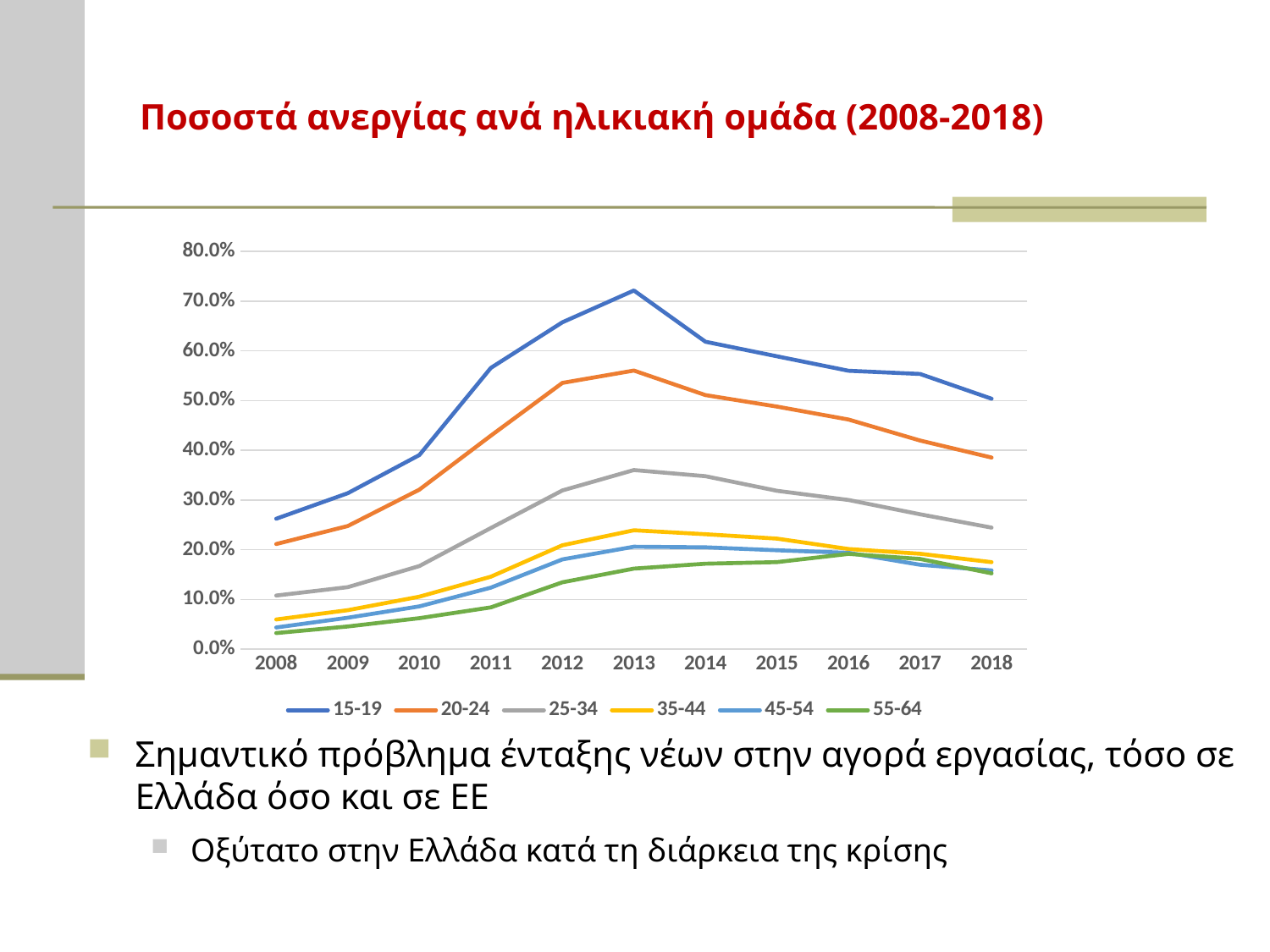
In 2008, which is larger: the value for 15-19 or the value for 20-24? 15-19 Is the value for 20-24 in 2018 greater or less than 40%? less Is the value for 25-34 in 2013 greater or less than 30%? greater Does the 15-19 series rise or fall from 2013 to 2018? fall What kind of chart is shown on the slide? line chart Which age group has the highest unemployment rate in 2013? 15-19 Is the value for 15-19 in 2013 greater or less than 70%? greater How many years are shown along the x axis? 11 In which year does the 15-19 series reach its peak? 2013 Which age group has the lowest unemployment rate in 2008? 55-64 How many series does the legend list? 6 What is the title of the chart on the slide? Ποσοστά ανεργίας ανά ηλικιακή ομάδα (2008-2018)